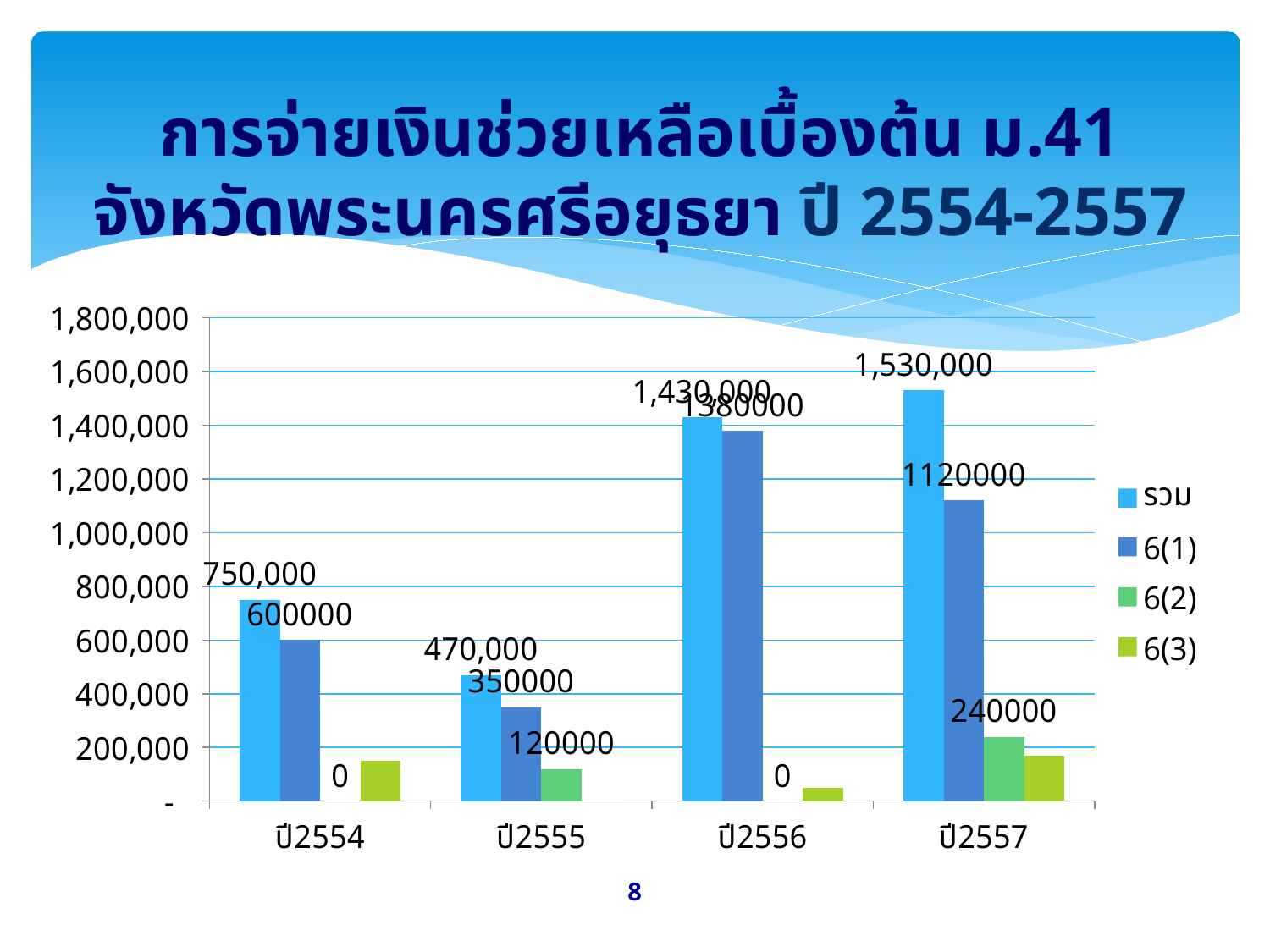
How many years are shown on the x axis? 4 Which is larger, the 6(1) value for ปี2554 or the 6(1) value for ปี2555? ปี2554 Is the value of 6(3) for ปี2554 greater or less than 200,000? less What is the value of 6(2) for ปี2555? 120000 Which year has the highest value for รวม? ปี2557 Which year has the lowest value for รวม? ปี2555 What is the value of รวม for ปี2554? 750,000 What is the value of รวม for ปี2557? 1,530,000 How many series does the legend list? 4 What is the value of 6(1) for ปี2556? 1380000 What kind of chart is shown on the slide? bar chart What is the difference between รวม and 6(1) for ปี2557? 410,000